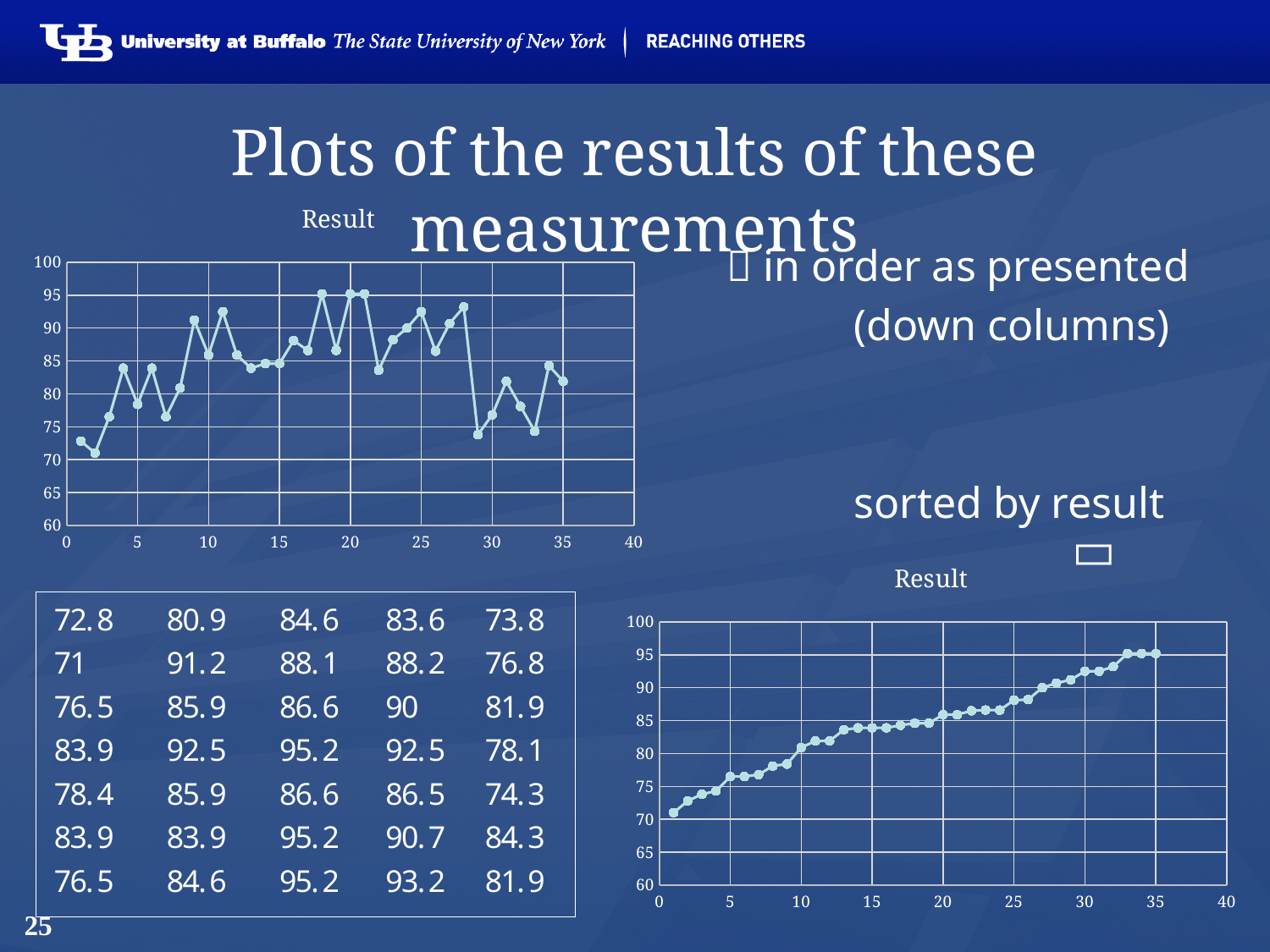
What kind of chart is the bottom-right chart titled "Result"? line chart In the bottom-right "Result" chart (sorted by result), do the values rise or fall along the x axis? rise In the bottom-right "Result" chart, is the value at x = 1 greater or less than 75? less In the top-left "Result" chart, which is larger: the value at x = 20 or the value at x = 2? x = 20 In the bottom-right "Result" chart, is the value at x = 35 greater or less than 90? greater In the top-left "Result" chart, is the value at x = 20 greater or less than 90? greater What is the lowest value shown on the y axis of the top-left "Result" chart? 60 How many data points are plotted in the top-left "Result" chart? 35 How many data points are plotted in the bottom-right "Result" chart? 35 What kind of chart is the top-left chart titled "Result"? line chart What is the title of the bottom-right chart? Result